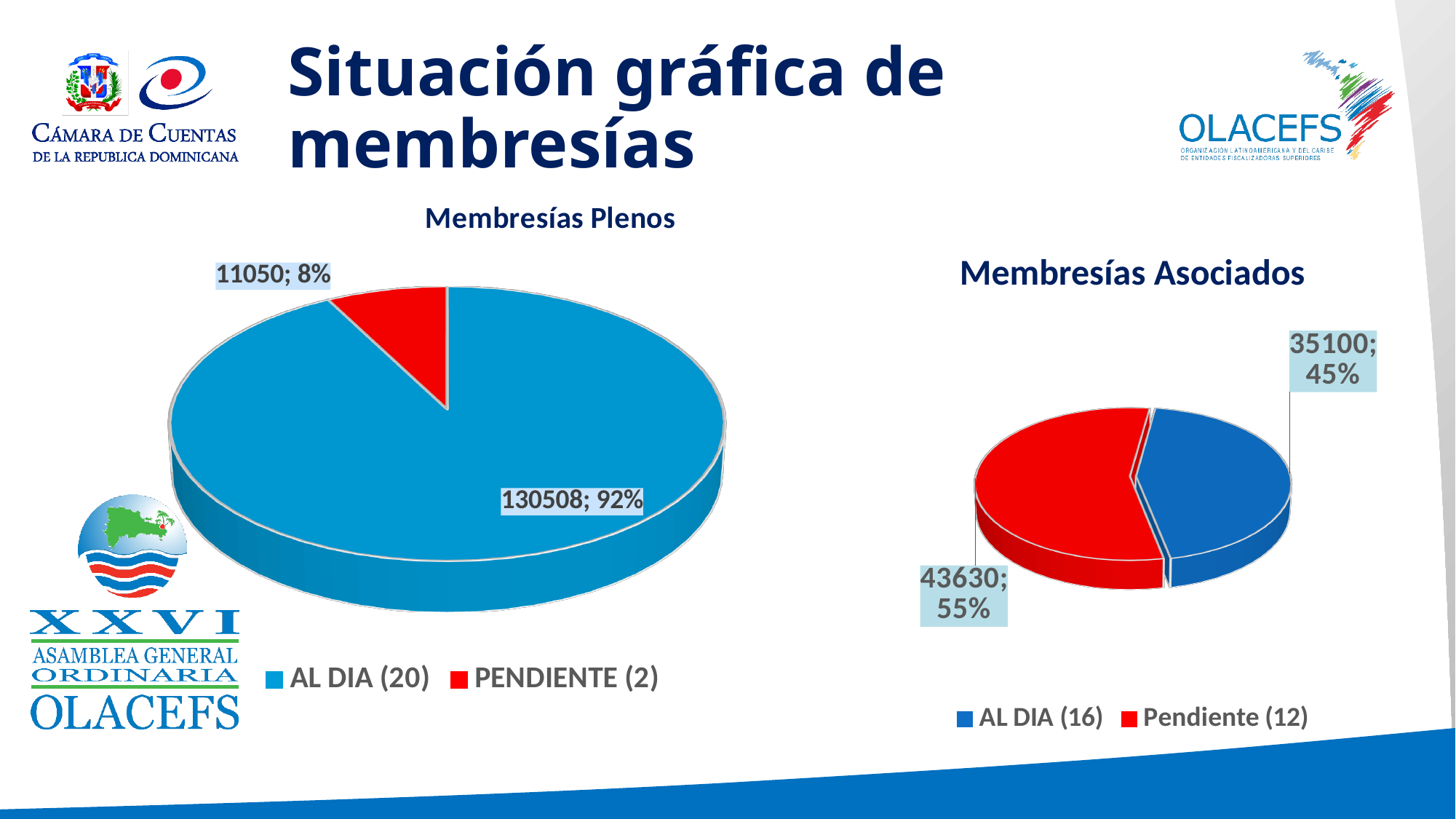
In the 'Membresías Asociados' chart, what is the value for Pendiente (12)? 43630 In the 'Membresías Plenos' chart, what is the value for AL DIA (20)? 130508 In the 'Membresías Asociados' chart, what share of the pie does Pendiente (12) represent? 55% In the 'Membresías Plenos' chart, what is the difference between the AL DIA (20) value and the PENDIENTE (2) value? 119458 In the 'Membresías Plenos' chart, what share of the pie does PENDIENTE (2) represent? 8% What kind of chart is the 'Membresías Plenos' chart? Pie chart In the 'Membresías Asociados' chart, what is the value for AL DIA (16)? 35100 How many entries does the legend of the 'Membresías Asociados' chart list? 2 In the 'Membresías Plenos' chart, which slice is the largest? AL DIA (20) In the 'Membresías Plenos' chart, what is the value for PENDIENTE (2)? 11050 In the 'Membresías Asociados' chart, what is the difference between the Pendiente (12) value and the AL DIA (16) value? 8530 In the 'Membresías Asociados' chart, which slice is the smallest? AL DIA (16)